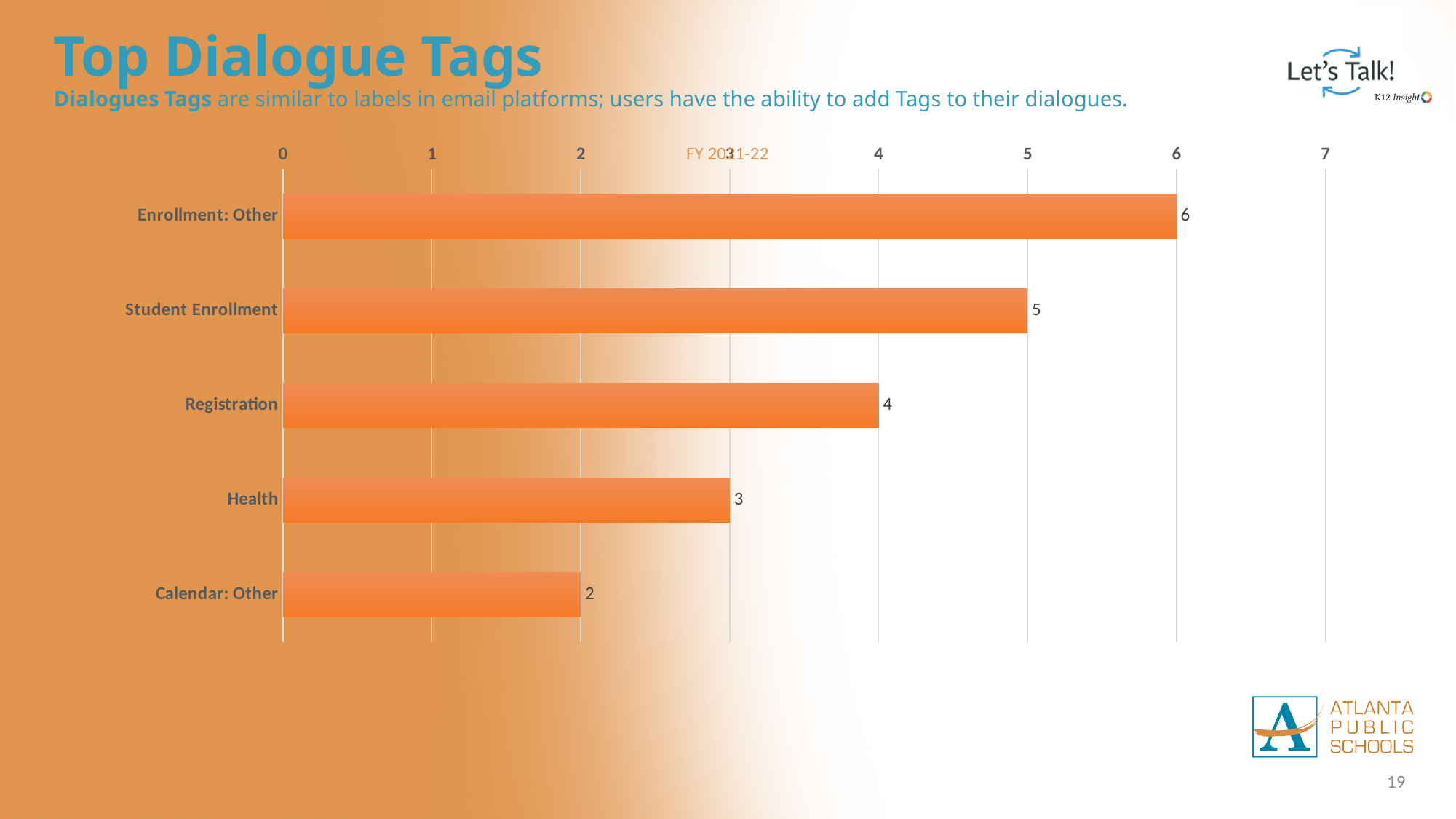
Which is larger, the value for Registration or the value for Calendar: Other? Registration What is the value for Enrollment: Other? 6 Which category has the lowest value? Calendar: Other What is the value for Registration? 4 Is the value for Student Enrollment greater or less than 4? greater What kind of chart is shown on the slide? bar chart What is the difference between the values for Student Enrollment and Health? 2 How many categories are shown in the chart? 5 What is the value for Calendar: Other? 2 Which category has the highest value? Enrollment: Other What is the value for Health? 3 What is the title of the slide containing the chart? Top Dialogue Tags